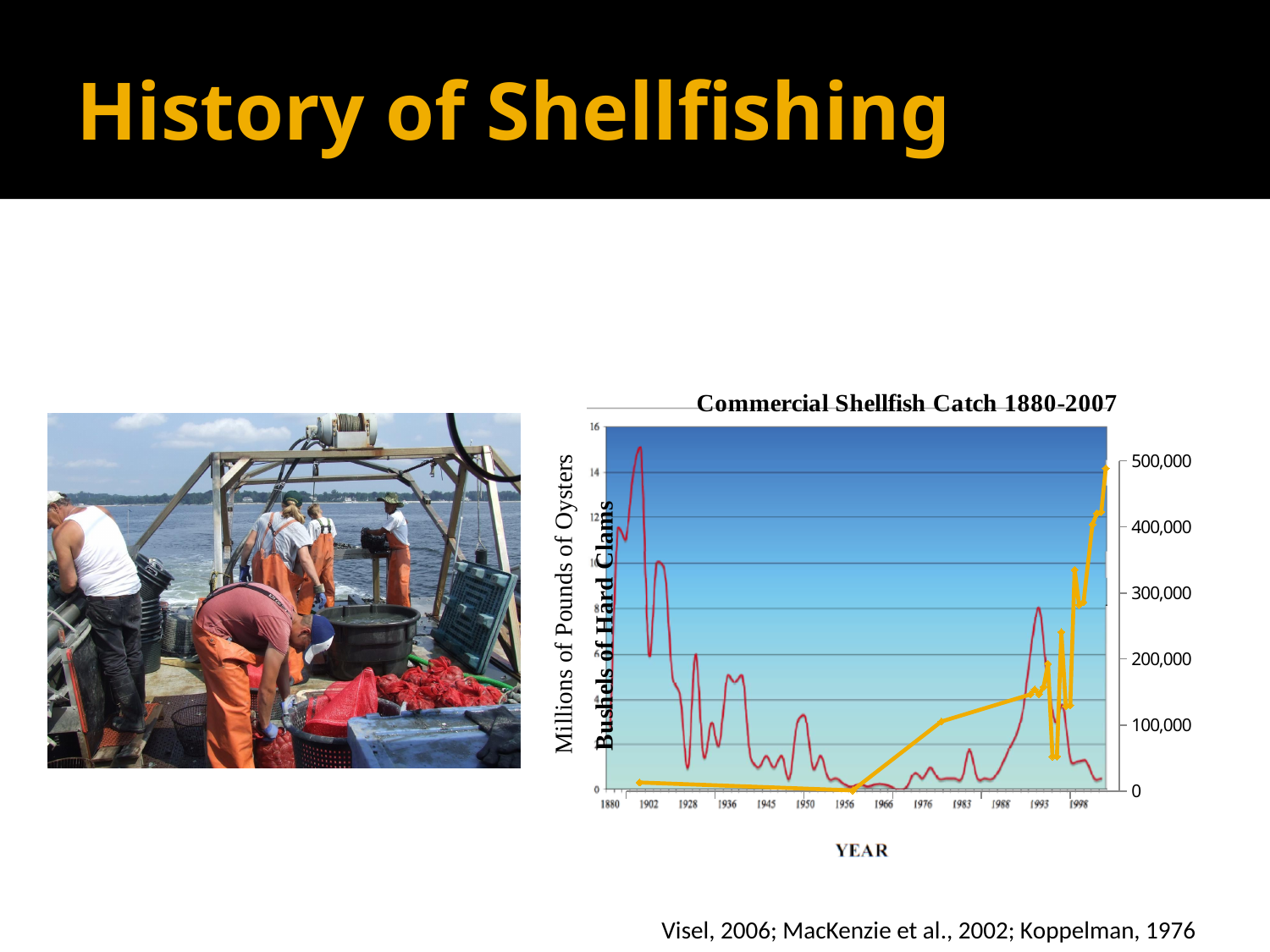
Is the peak value of the oyster line (around 1902) greater or less than 14 million pounds? greater Is the value of the hard clam line at the end of the series (around 2007) greater or less than 400,000 bushels? greater What is the highest value shown on the left-hand axis (Millions of Pounds of Oysters)? 16 Does the hard clam line rise or fall from 1956 to 2007? Rises What is the title of the chart on the slide? Commercial Shellfish Catch 1880-2007 How many year labels are printed along the x axis of the chart? 13 What is the label of the x axis of the chart? YEAR Does the oyster line overall rise or fall from 1902 to 1956? Falls How many lines (series) are plotted on the chart? 2 What kind of chart is shown on the slide? Line chart Is the value of the hard clam line around 1956 greater or less than 100,000 bushels? less What is the highest value shown on the right-hand axis (Bushels of Hard Clams)? 500,000